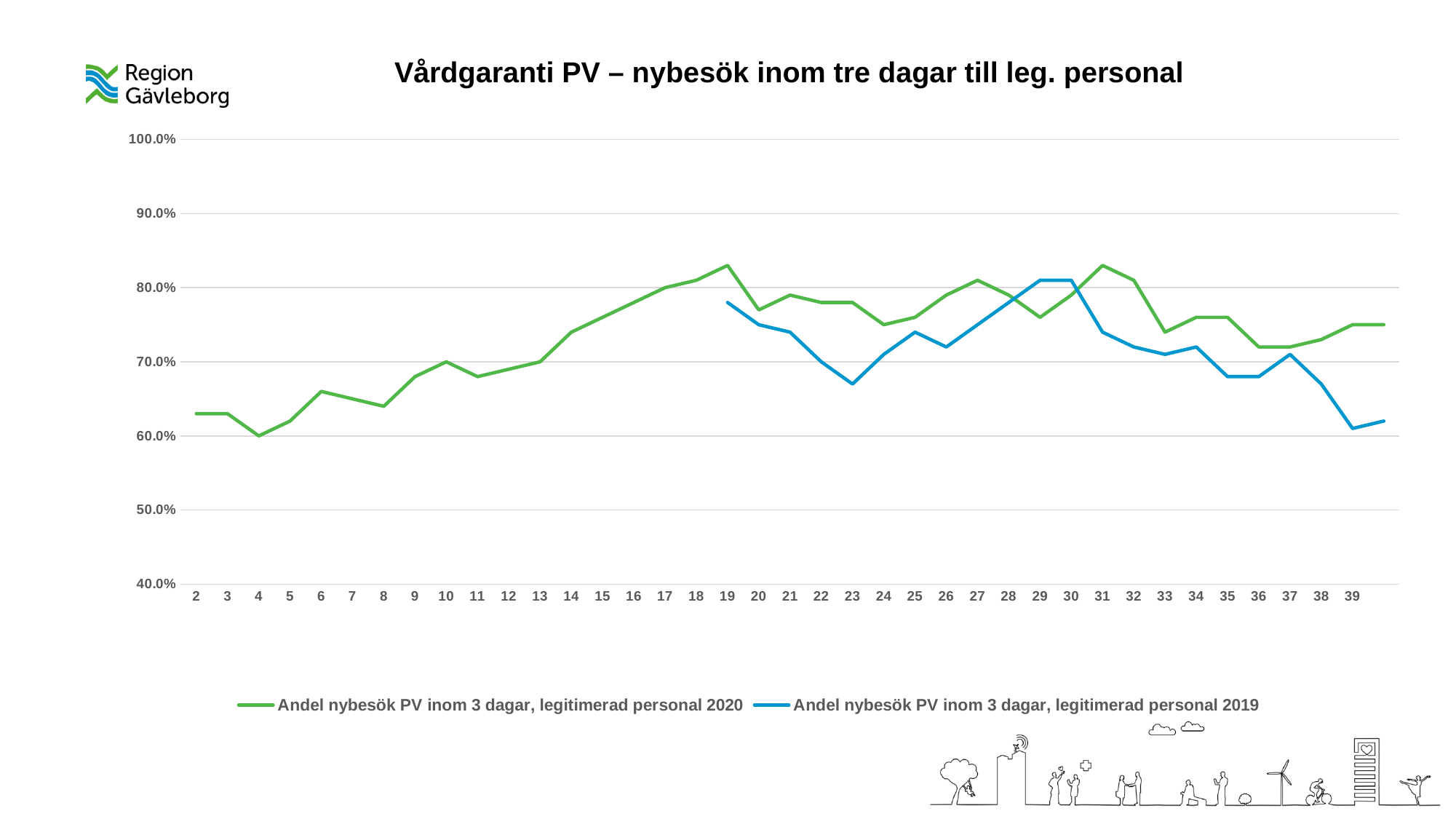
Is the value for the 2020 series at week 4 greater or less than 70.0%? less Does the 2020 series generally rise or fall from week 2 to week 19? rise Which colour is used for the series 'Andel nybesök PV inom 3 dagar, legitimerad personal 2019'? blue Is the value for the 2020 series at week 19 greater or less than 80.0%? greater What kind of chart is shown on the slide? line chart Is the value for the 2019 series at week 38 greater or less than 70.0%? less At week 29, which series has the higher value, 2020 or 2019? 2019 What is the title of the chart? Vårdgaranti PV – nybesök inom tre dagar till leg. personal How many series does the legend list? 2 At week 31, which series has the higher value, 2020 or 2019? 2020 Does the 2019 series generally rise or fall from week 30 to week 38? fall